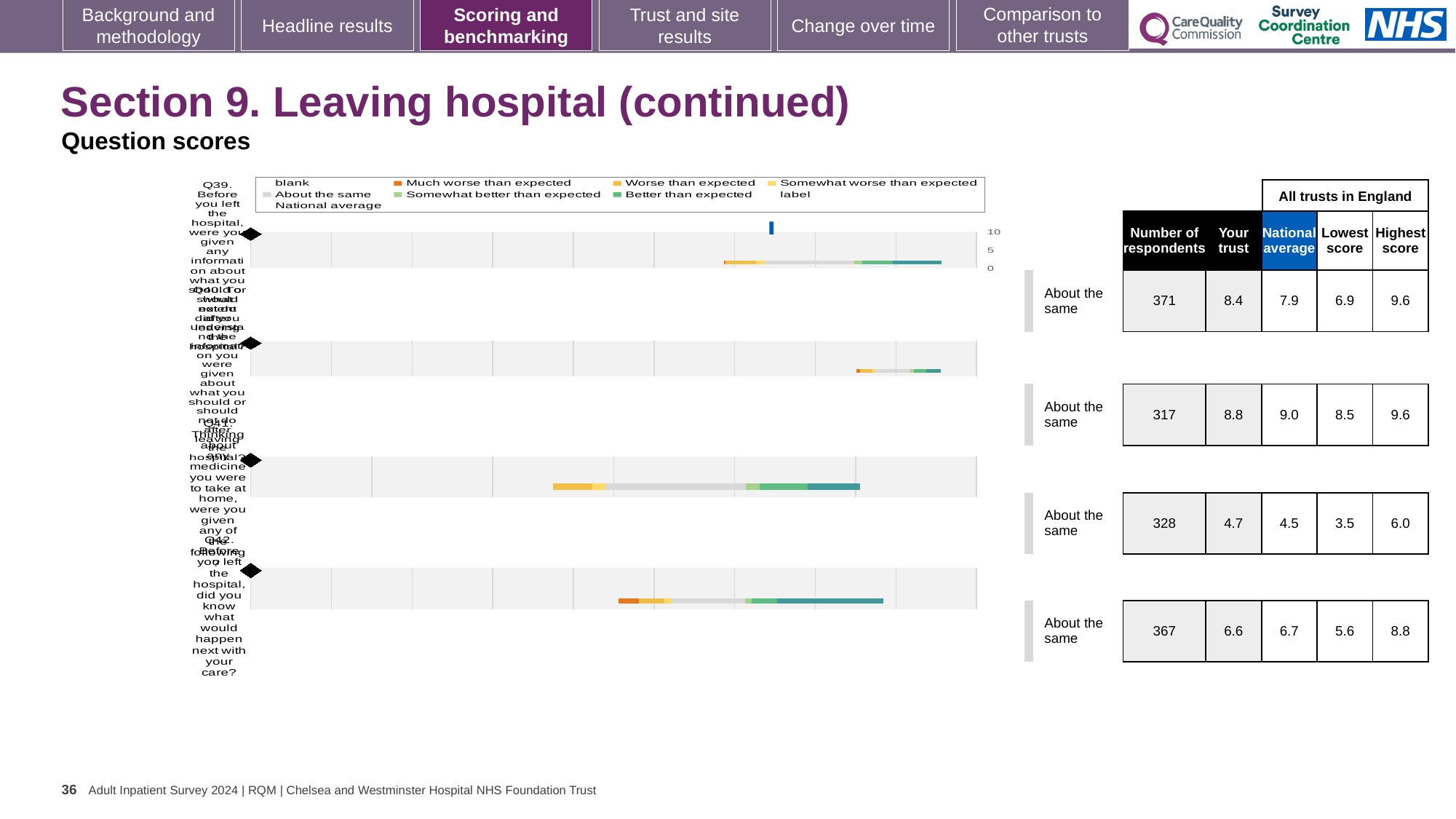
In the table, what is the national average in the third row (Q41)? 4.5 In the first row of the table (Q39), what is the difference between the 'Your trust' score and the national average? 0.5 What kind of chart is shown on the left of the slide? bar chart In the table, what is the highest score in the fourth row (Q42)? 8.8 How many question rows (Q39 to Q42) are plotted in the chart? 4 Which row of the table has the lowest 'Your trust' score? third row (Q41), 4.7 How many entries does the chart legend list? 9 In the first row of the table (Q39), which is larger: the 'Your trust' score or the national average? Your trust In the table, what is the 'Your trust' score in the first row (Q39)? 8.4 What benchmark category is shown next to each of the four question rows? About the same In the table, what is the number of respondents in the first row (Q39)? 371 Which row of the table has the highest number of respondents? first row (Q39), 371